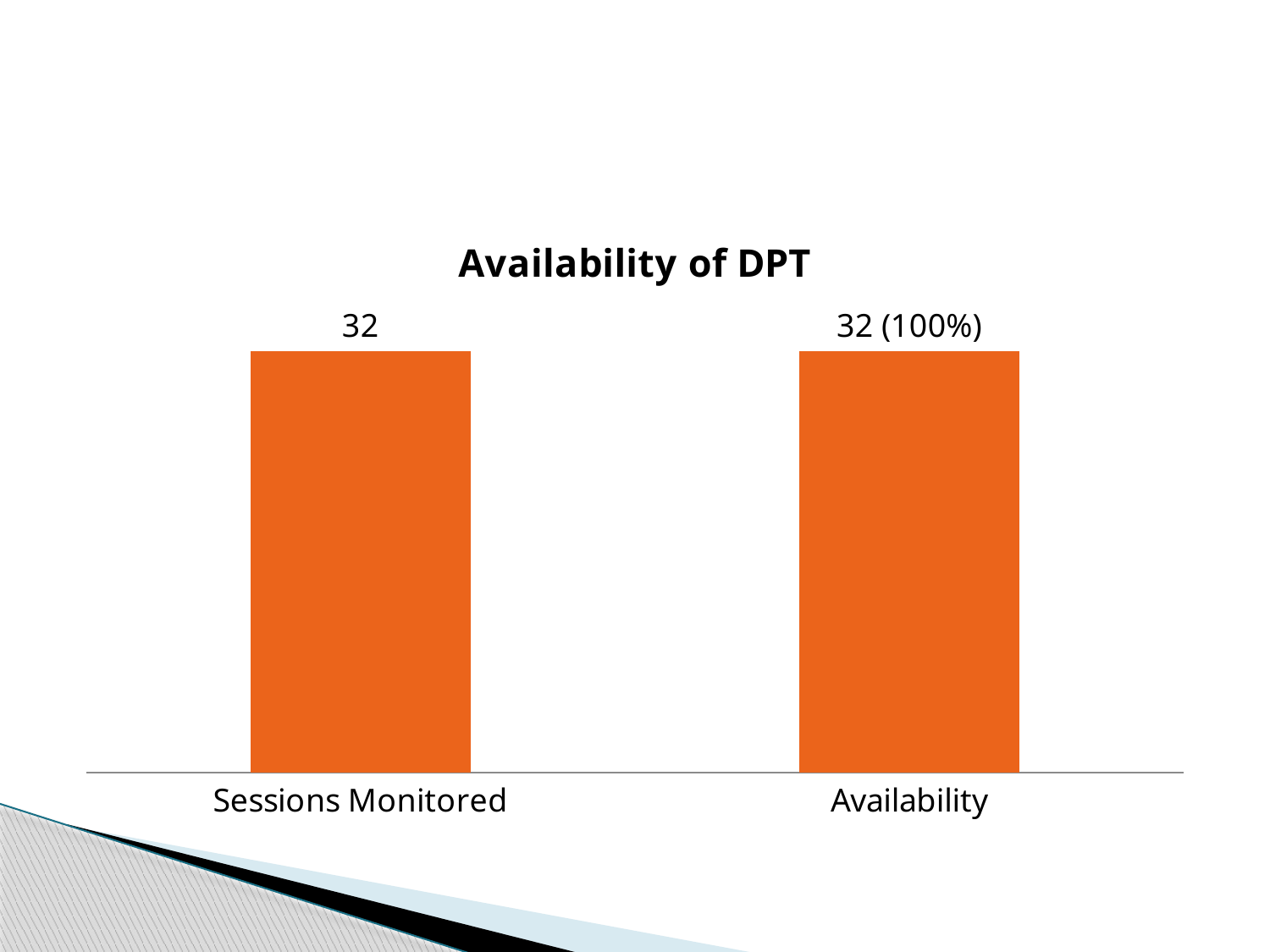
What is the difference between the Sessions Monitored value and the Availability value? 0 What percentage is shown in the data label for Availability? 100% How many bars are plotted in the chart? 2 What kind of chart is shown on the slide? bar chart What are the two category labels on the x axis? Sessions Monitored, Availability What is the value for Sessions Monitored? 32 What is the title of the chart? Availability of DPT What is the data label shown on the Availability bar? 32 (100%) What colour are the bars in the chart? orange